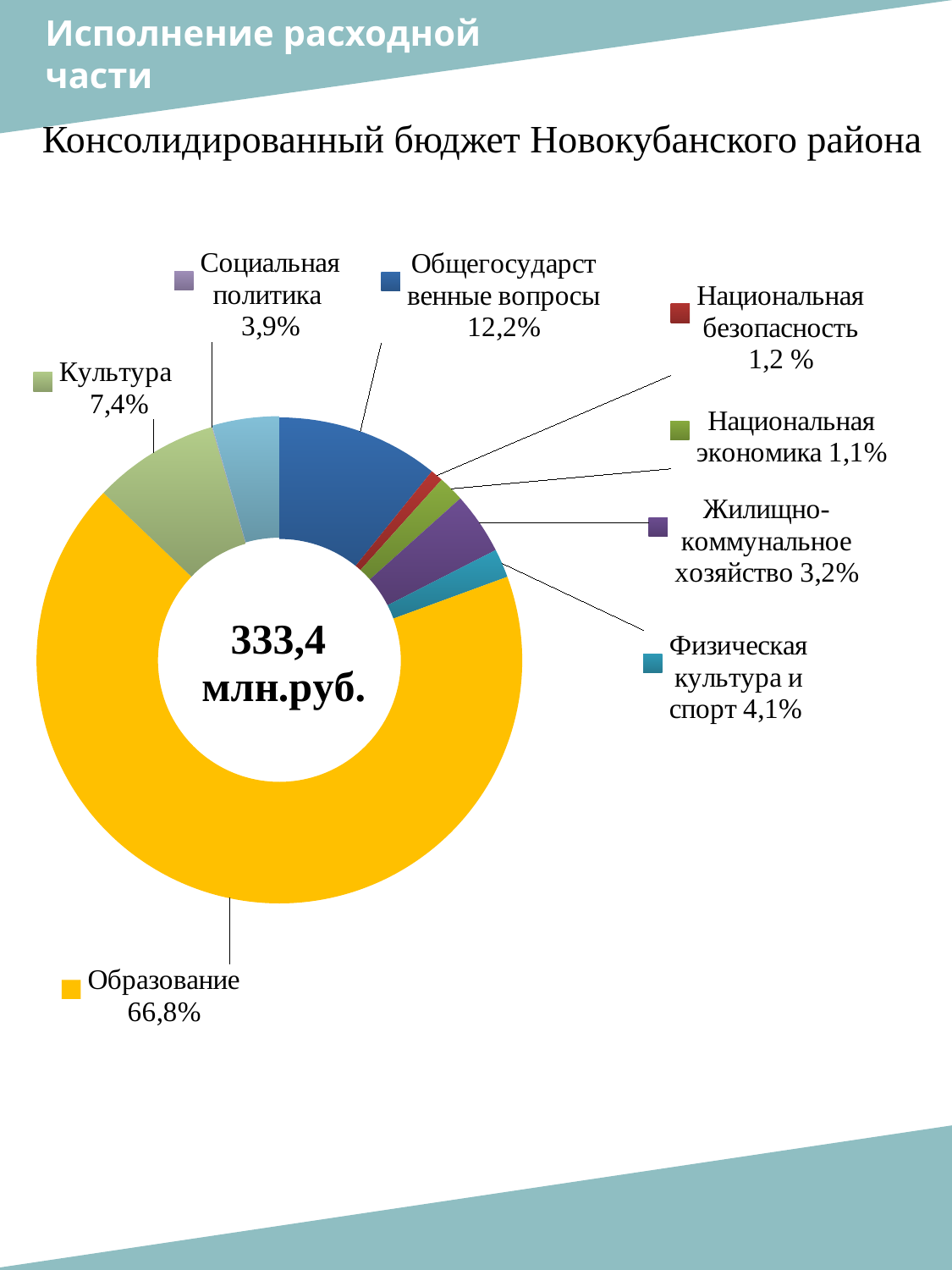
What share of the consolidated budget expenditure goes to Образование? 66,8% Which has a larger share: Физическая культура и спорт or Социальная политика? Физическая культура и спорт What percentage is shown for Жилищно-коммунальное хозяйство? 3,2% Which expenditure category has the smallest share of the budget? Национальная экономика Which expenditure category has the largest share of the budget? Образование What total amount is shown in the centre of the chart? 333,4 млн.руб. What share of expenditure is shown for Общегосударственные вопросы? 12,2% What colour is the segment for Образование? Yellow How many expenditure categories are shown in the chart? 8 What percentage is shown for Культура? 7,4% What is the difference in percentage points between Общегосударственные вопросы and Культура? 4,8 What type of chart is used on the slide? Doughnut (pie) chart